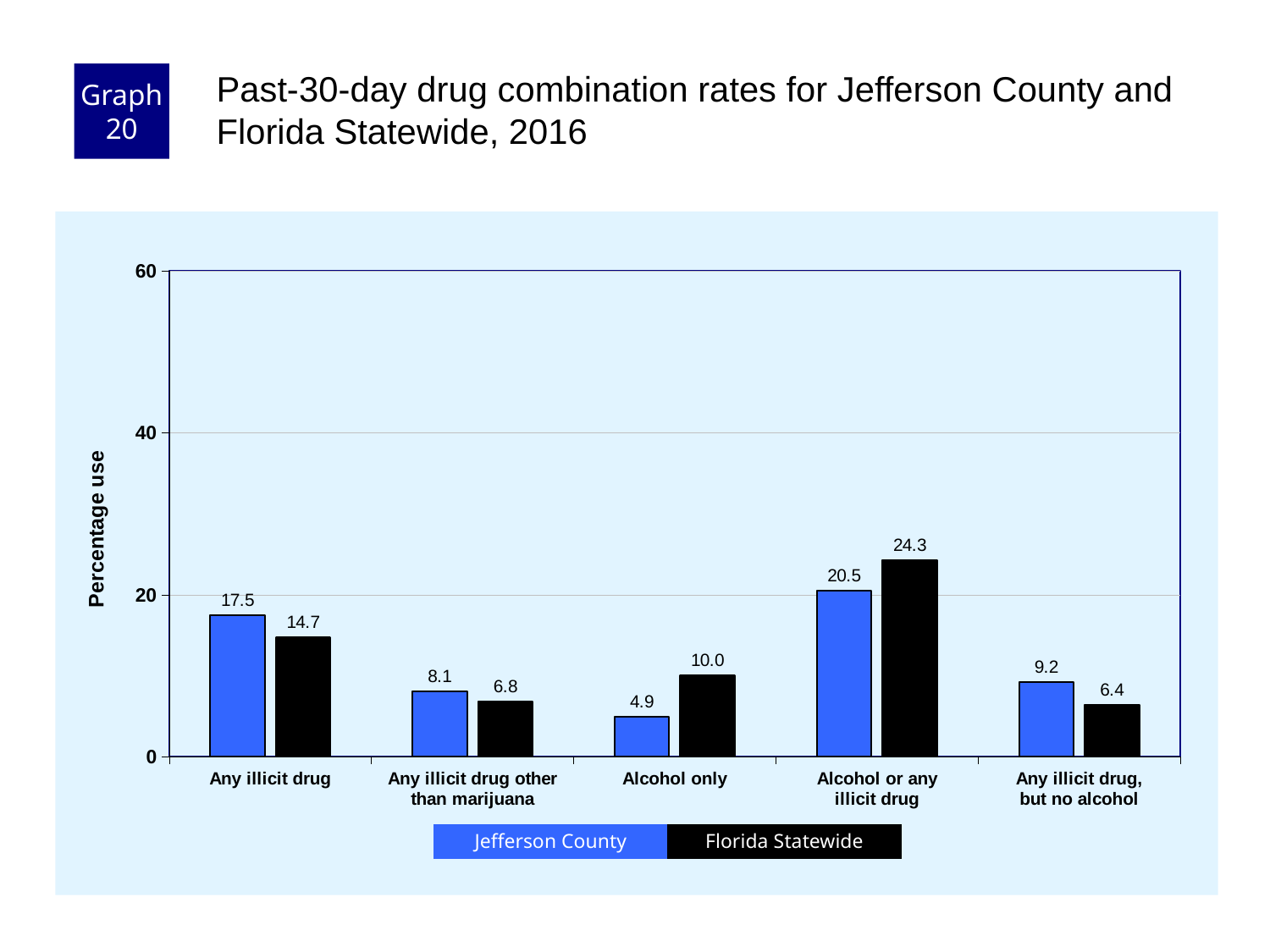
What is the Jefferson County value for Any illicit drug? 17.5 How many series does the legend list? 2 What is the difference between the Jefferson County and Florida Statewide values for Any illicit drug? 2.8 Which category has the lowest Jefferson County value? Alcohol only What is the difference between the Florida Statewide and Jefferson County values for Alcohol or any illicit drug? 3.8 What is the Florida Statewide value for Alcohol only? 10.0 What kind of chart is shown on the slide? Bar chart What is the Jefferson County value for Any illicit drug, but no alcohol? 9.2 Which is larger for Alcohol only: Jefferson County or Florida Statewide? Florida Statewide How many categories are shown on the x axis? 5 Is the Florida Statewide value for Alcohol or any illicit drug greater or less than 20? greater Which category has the highest Florida Statewide value? Alcohol or any illicit drug